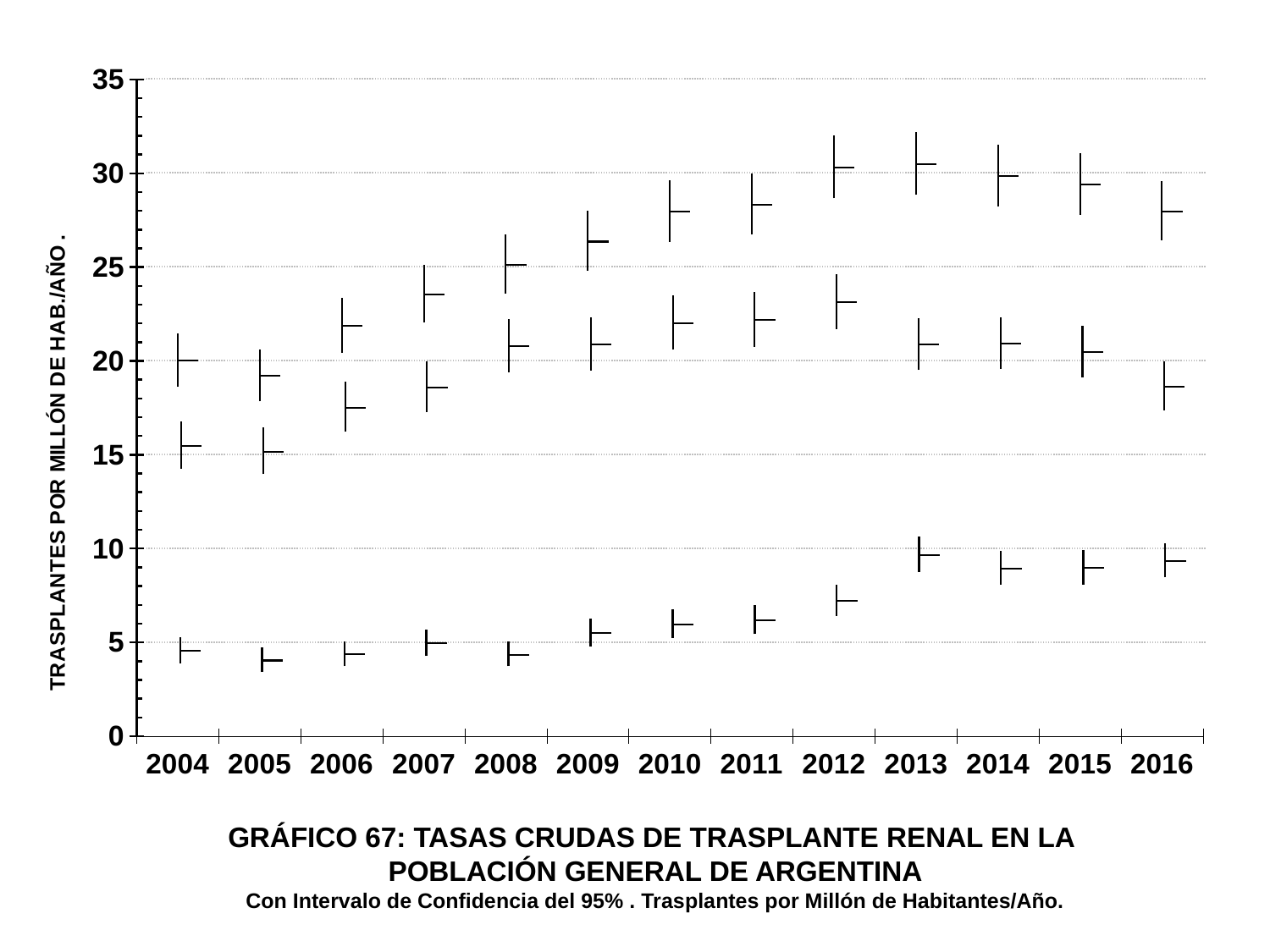
What confidence interval does the chart subtitle say is used? 95% Does the bottom series generally rise or fall from 2004 to 2016? rise What is the first year shown on the x axis? 2004 Is the value of the top series in 2013 greater or less than 25? greater Is the value of the bottom series in 2005 greater or less than 5? less Is the value of the middle series in 2016 greater or less than 20? less How many years are shown on the x axis of the chart? 13